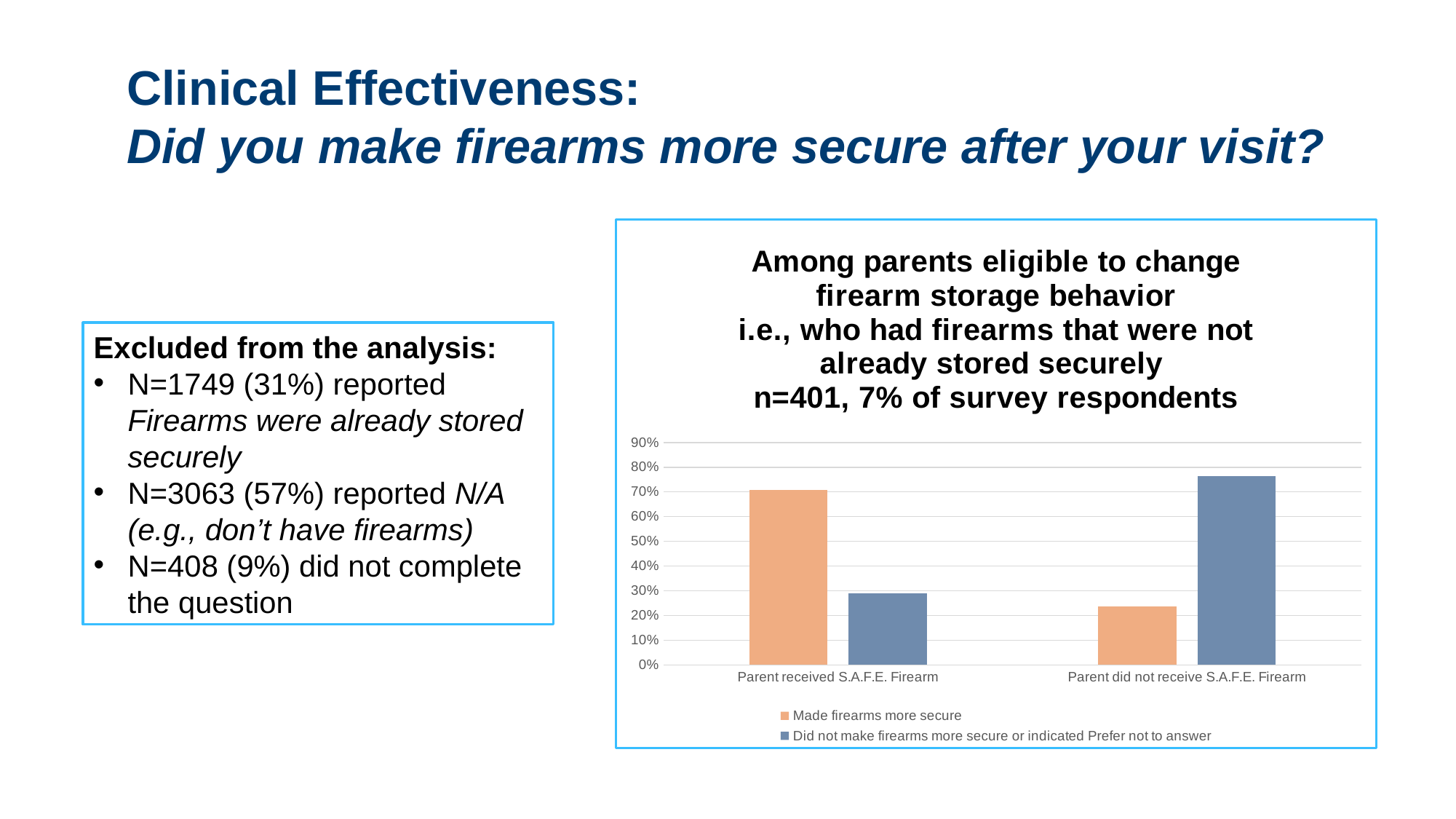
Is the value for 'Did not make firearms more secure or indicated Prefer not to answer' among parents who did not receive S.A.F.E. Firearm greater or less than 70%? greater Is the value for 'Did not make firearms more secure or indicated Prefer not to answer' among parents who received S.A.F.E. Firearm greater or less than 40%? less How many series does the chart's legend list? 2 What colour are the bars for the 'Made firearms more secure' series? orange What kind of chart is shown on the slide? bar chart Which category has the higher value for 'Made firearms more secure': parents who received S.A.F.E. Firearm or parents who did not receive S.A.F.E. Firearm? Parent received S.A.F.E. Firearm Which bar in the chart is the shortest? Made firearms more secure, Parent did not receive S.A.F.E. Firearm Which bar in the chart is the tallest? Did not make firearms more secure or indicated Prefer not to answer, Parent did not receive S.A.F.E. Firearm Is the value for 'Made firearms more secure' among parents who did not receive S.A.F.E. Firearm greater or less than 30%? less How many categories are shown on the x axis of the chart? 2 Among parents who did not receive S.A.F.E. Firearm, which series has the larger value? Did not make firearms more secure or indicated Prefer not to answer